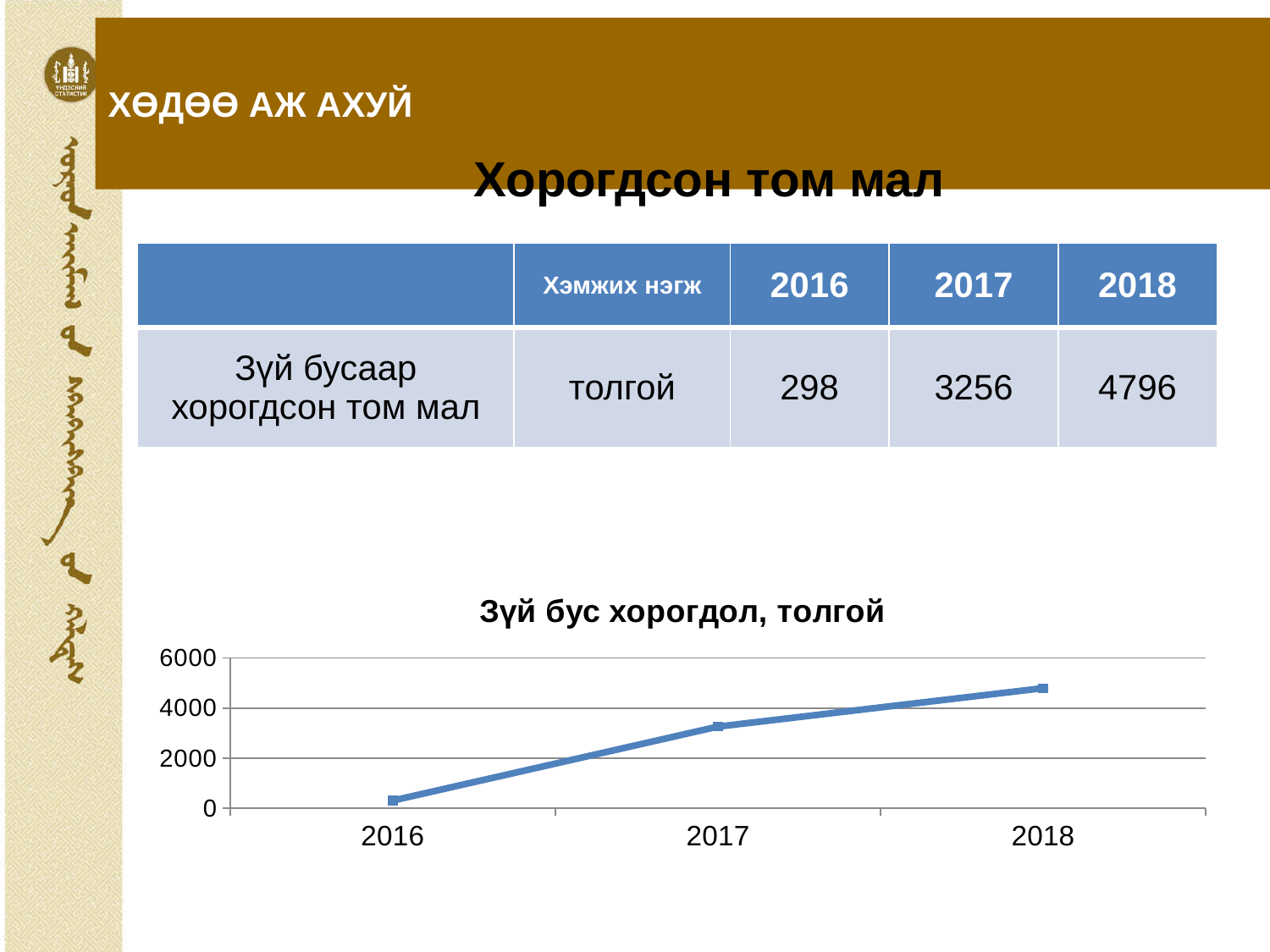
According to the table on the slide, what is the difference between the values plotted for 2018 and 2016? 4498 According to the table on the slide, what is the value plotted for 2017 in the chart? 3256 What is the title of the chart? Зүй бус хорогдол, толгой Which year has the lowest value in the chart? 2016 What kind of chart is shown on the slide? line chart Do the values in the chart rise or fall from 2016 to 2018? rise Is the value for 2017 in the chart greater or less than 2000? greater Which year has the highest value in the chart? 2018 Is the value for 2016 in the chart greater or less than 2000? less Is the value for 2018 in the chart greater or less than 4000? greater How many years are plotted on the x axis of the chart? 3 Which is larger in the chart, the value for 2017 or the value for 2018? 2018